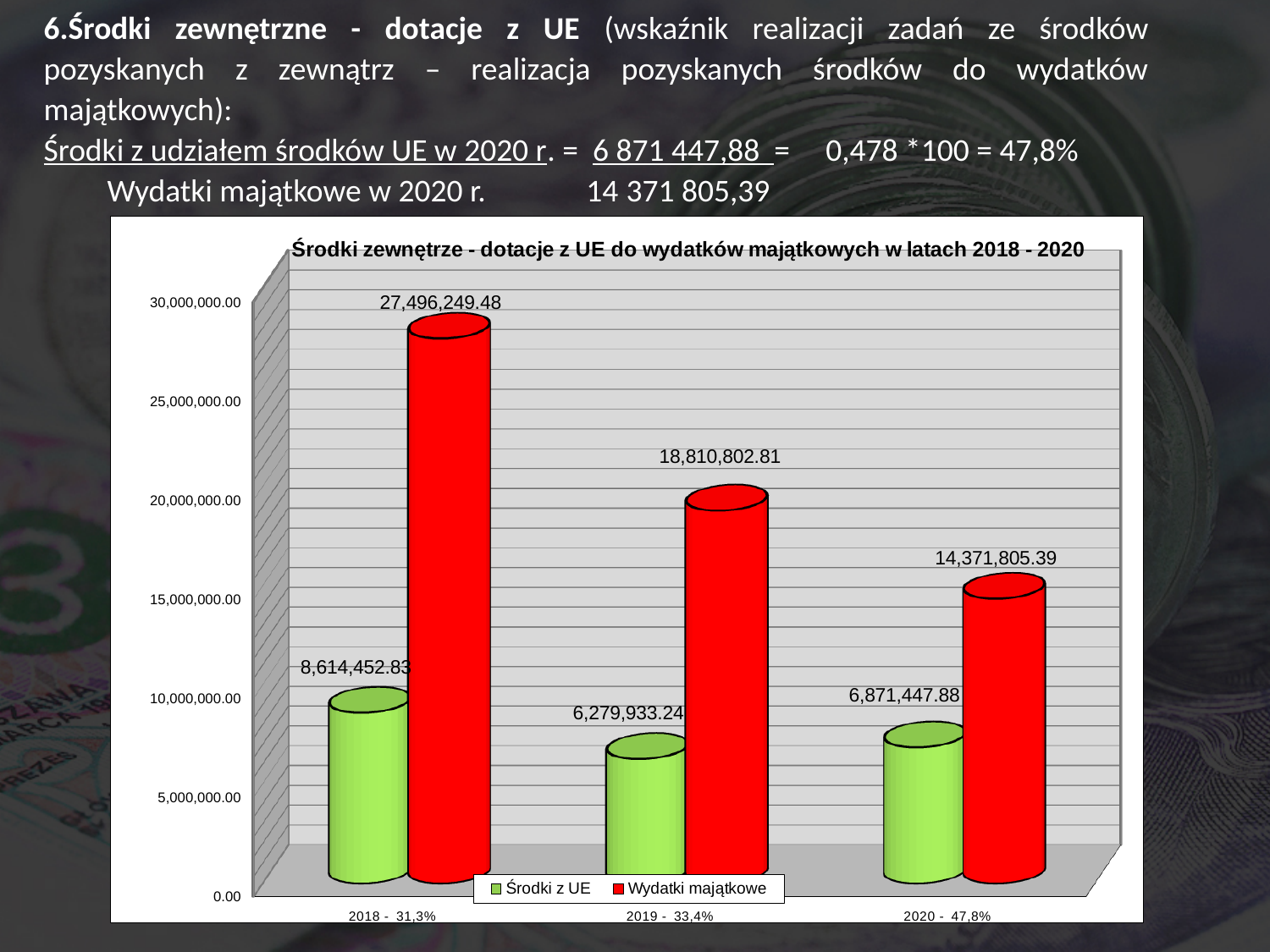
What is the value of Wydatki majątkowe for 2019 - 33,4%? 18,810,802.81 How many categories are shown on the x axis? 3 What is the value of Środki z UE for 2020 - 47,8%? 6,871,447.88 What kind of chart is shown on the slide? Bar chart Which category has the lowest value for Środki z UE? 2019 - 33,4% What is the value of Środki z UE for 2019 - 33,4%? 6,279,933.24 What is the difference between Wydatki majątkowe and Środki z UE for 2020 - 47,8%? 7,500,357.51 Which category has the highest value for Wydatki majątkowe? 2018 - 31,3% What is the difference in Wydatki majątkowe between 2018 - 31,3% and 2019 - 33,4%? 8,685,446.67 How many series does the legend list? 2 Which is larger: Środki z UE for 2018 - 31,3% or Środki z UE for 2020 - 47,8%? Środki z UE for 2018 - 31,3% What is the value of Wydatki majątkowe for 2018 - 31,3%? 27,496,249.48